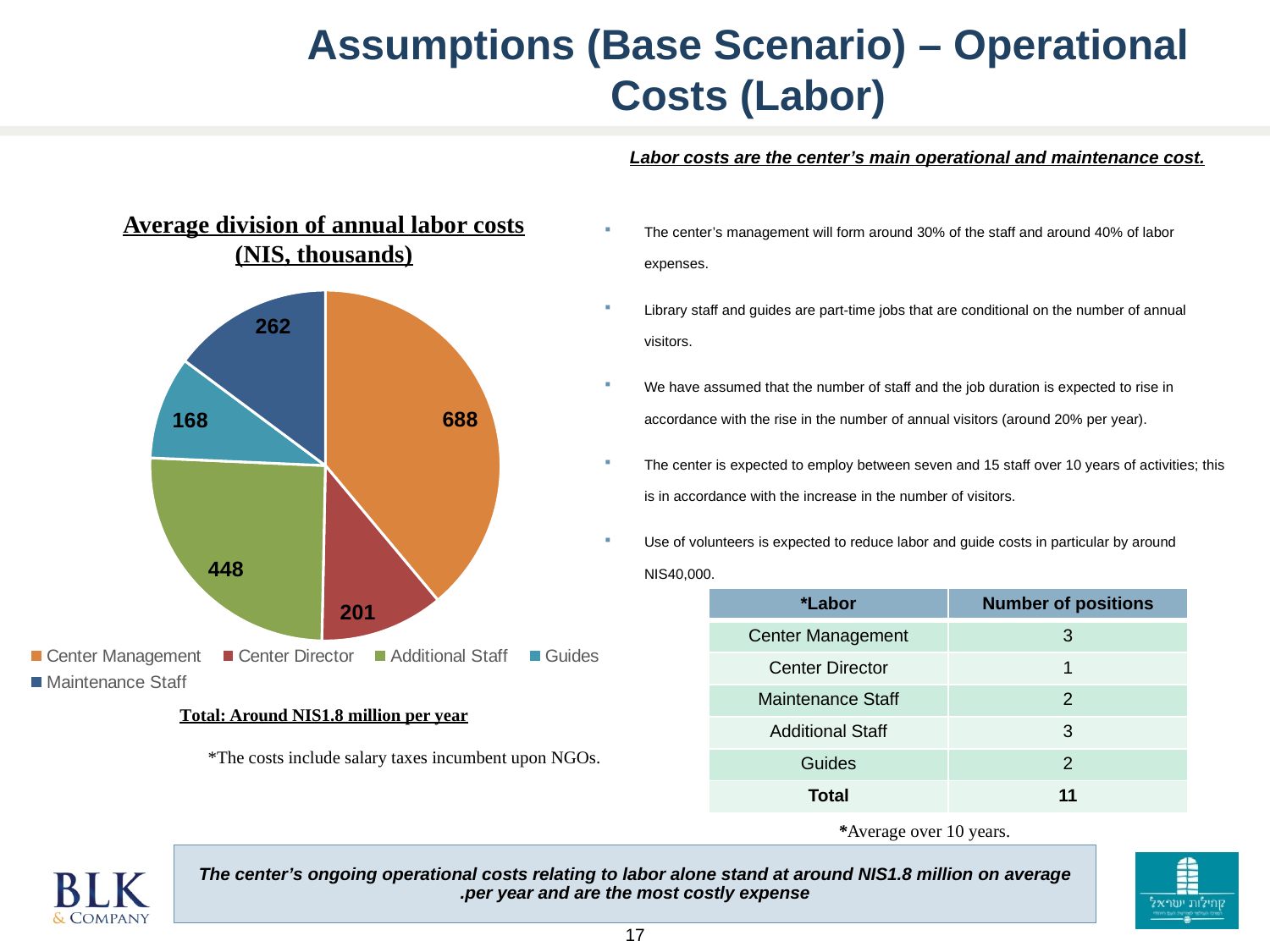
Which category has the smallest slice in the pie chart? Guides What is the value for Center Management in the pie chart? 688 What is the difference between the Center Management and Additional Staff values in the pie chart? 240 Which category has the largest slice in the pie chart? Center Management Which is larger in the pie chart, Center Director or Maintenance Staff? Maintenance Staff How many entries does the pie chart's legend list? 5 How many categories does the pie chart show? 5 What is the value for Additional Staff in the pie chart? 448 What is the title of the chart on the slide? Average division of annual labor costs (NIS, thousands) What is the value for Guides in the pie chart? 168 What is the value for Maintenance Staff in the pie chart? 262 What kind of chart is shown on the slide? Pie chart